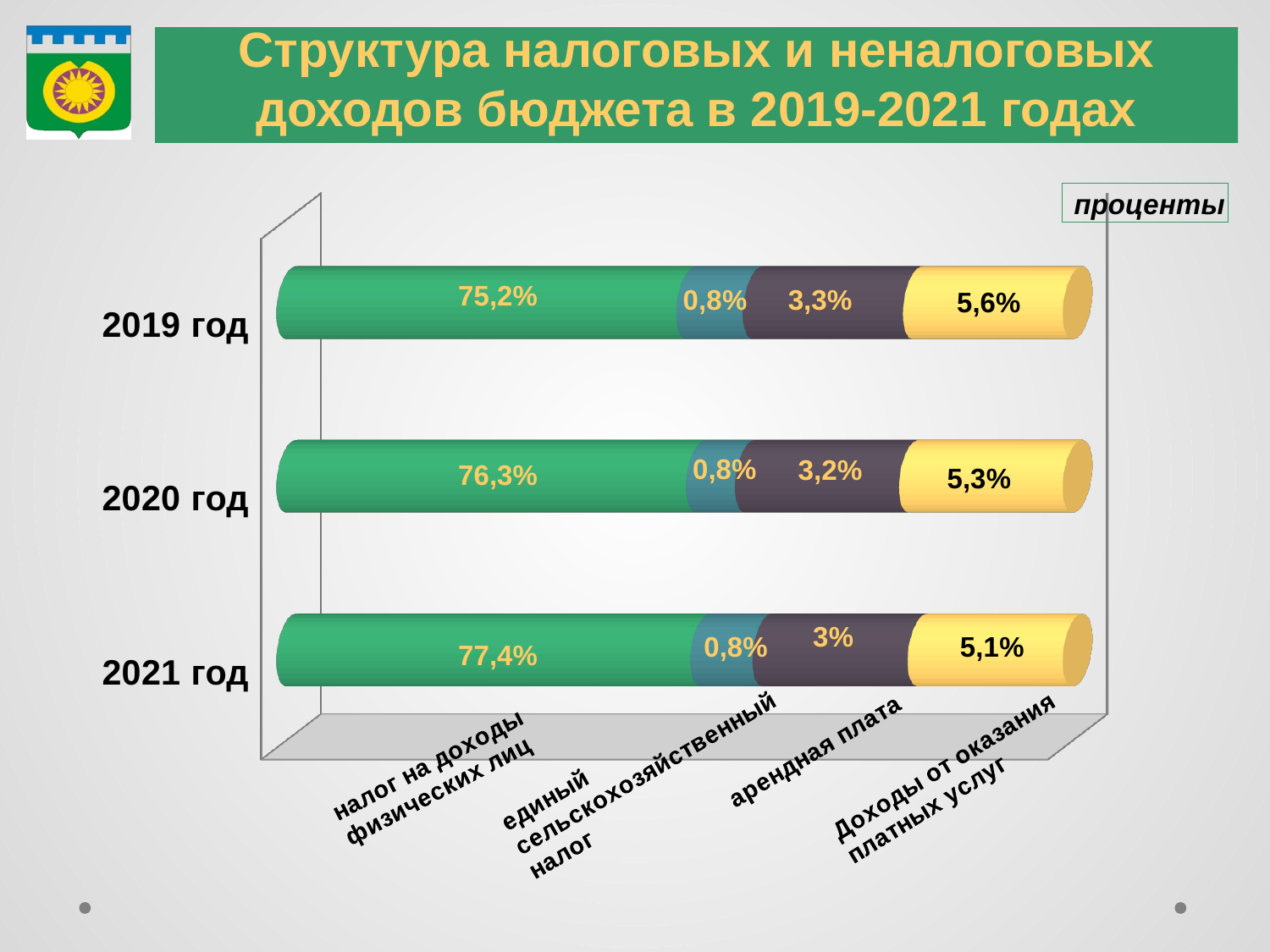
Какова доля арендной платы в 2020 году? 3,2% На сколько доля налога на доходы физических лиц в 2021 году больше, чем в 2019 году? 2,2% Что больше: доля арендной платы в 2019 году или в 2021 году? 2019 год Какова доля единого сельскохозяйственного налога в 2021 году? 0,8% Какова доля налога на доходы физических лиц в 2019 году? 75,2% Какова доля доходов от оказания платных услуг в 2021 году? 5,1% В каком году доля доходов от оказания платных услуг была наименьшей? 2021 год В каком году доля налога на доходы физических лиц была наибольшей? 2021 год Сколько лет (категорий) показано на диаграмме? 3 Какого типа эта диаграмма? столбчатая (линейчатая) диаграмма с накоплением Какова сумма всех показанных долей за 2019 год? 84,9% Как меняется доля налога на доходы физических лиц с 2019 по 2021 год? растёт